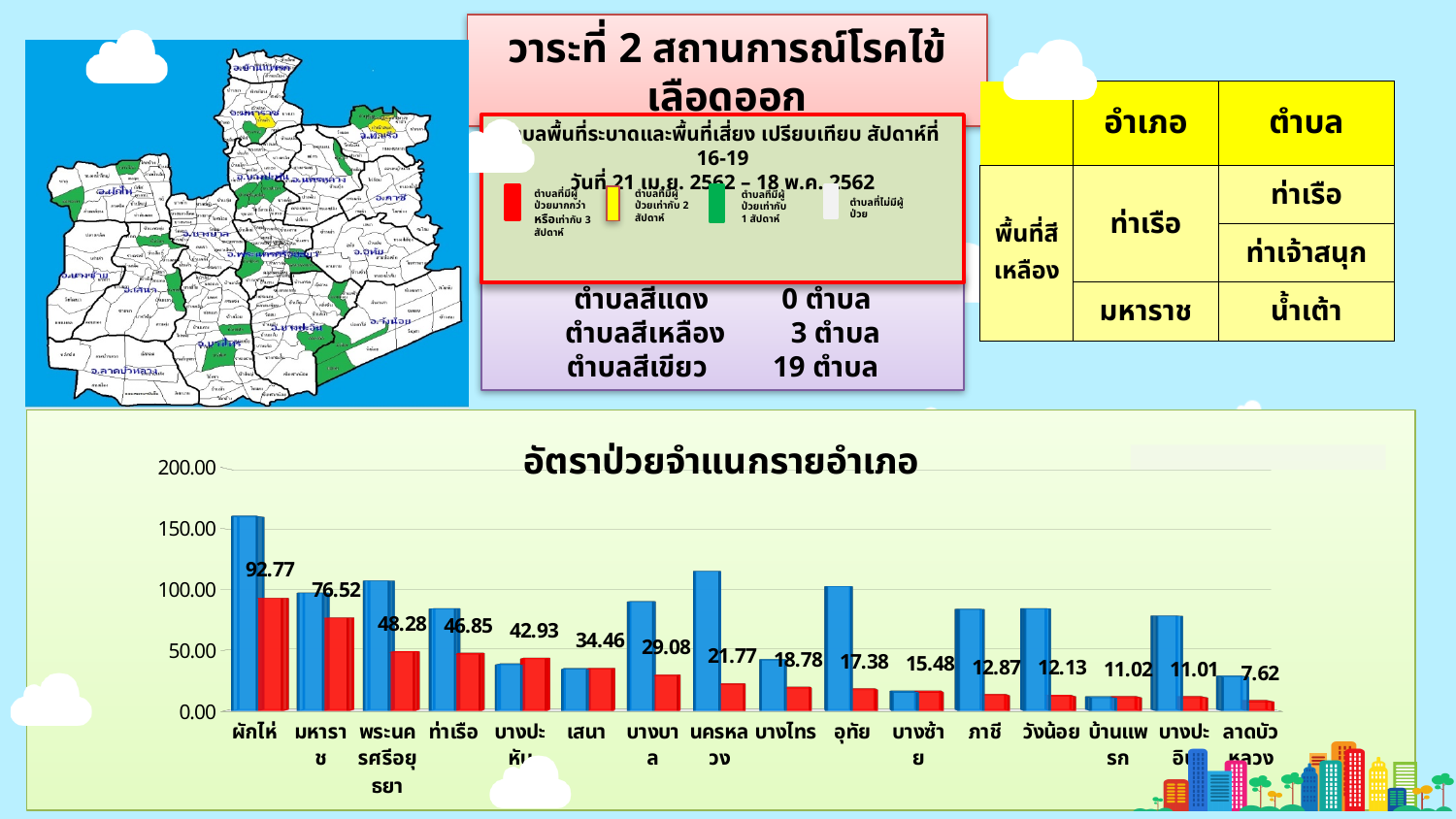
Which has the larger labelled value in the chart อัตราป่วยจำแนกรายอำเภอ, เสนา or อุทัย? เสนา How many districts are shown on the x axis of the chart อัตราป่วยจำแนกรายอำเภอ? 16 What kind of chart is อัตราป่วยจำแนกรายอำเภอ? bar chart Is the value of the blue bar for บางซ้าย in the chart อัตราป่วยจำแนกรายอำเภอ greater or less than 50? less What is the labelled value for บางบาล in the chart อัตราป่วยจำแนกรายอำเภอ? 29.08 Do the labelled red-bar values in the chart อัตราป่วยจำแนกรายอำเภอ rise or fall from left to right? fall What is the labelled value for ท่าเรือ in the chart อัตราป่วยจำแนกรายอำเภอ? 46.85 What is the difference between the labelled values for ผักไห่ and มหาราช in the chart อัตราป่วยจำแนกรายอำเภอ? 16.25 Is the value of the blue bar for ผักไห่ in the chart อัตราป่วยจำแนกรายอำเภอ greater or less than 150? greater What is the labelled value for ผักไห่ in the chart อัตราป่วยจำแนกรายอำเภอ? 92.77 Which district has the lowest labelled value in the chart อัตราป่วยจำแนกรายอำเภอ? ลาดบัวหลวง Which district has the highest labelled value in the chart อัตราป่วยจำแนกรายอำเภอ? ผักไห่